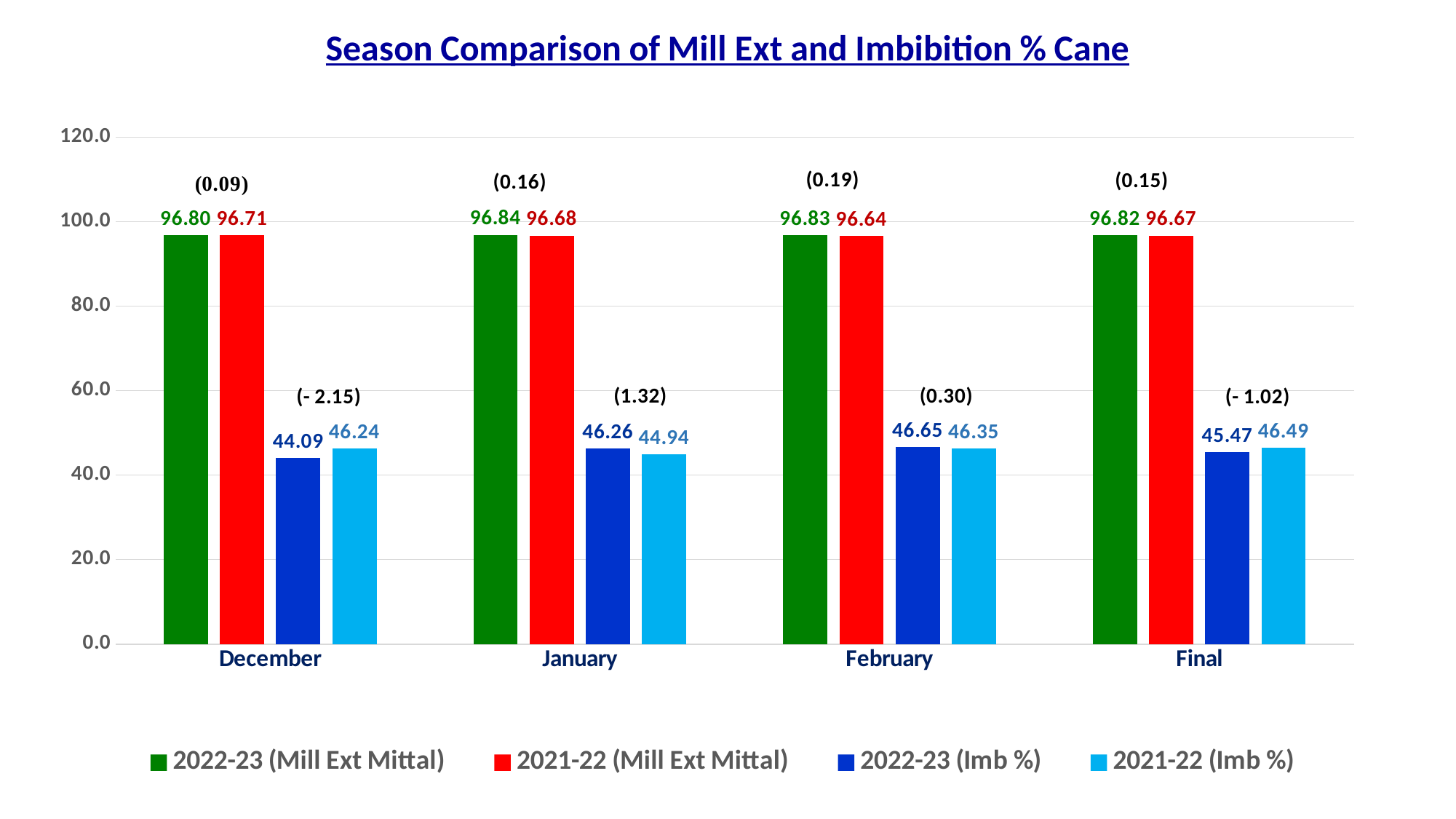
What is the value for 2022-23 (Imb %) in Final? 45.47 What is the difference between 2022-23 (Imb %) and 2021-22 (Imb %) in December? 2.15 What kind of chart is shown on the slide? Bar chart How many categories are shown on the x axis? 4 How many series does the legend list? 4 Which is larger in January: 2022-23 (Imb %) or 2021-22 (Imb %)? 2022-23 (Imb %) What is the value for 2022-23 (Mill Ext Mittal) in December? 96.80 Which category has the highest value for 2022-23 (Imb %)? February What is the value for 2021-22 (Mill Ext Mittal) in February? 96.64 Which category has the lowest value for 2022-23 (Imb %)? December Is the value for 2021-22 (Imb %) in Final greater or less than 40.0? greater What is the value for 2021-22 (Imb %) in January? 44.94